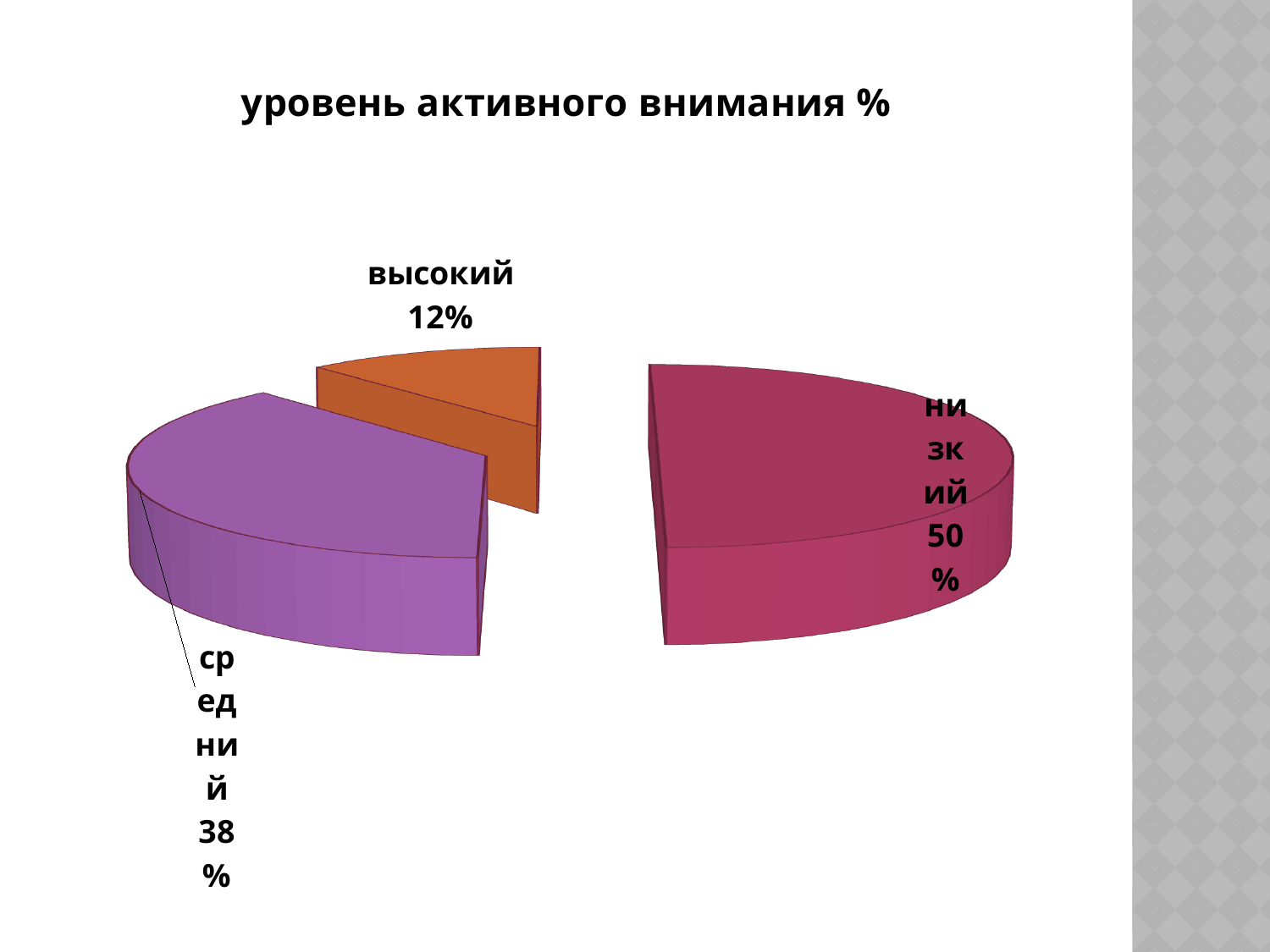
What percentage is shown for the "низкий" slice? 50% Which is larger, the "средний" share or the "высокий" share? средний Which category has the largest share of the pie? низкий How many slices does the pie chart have? 3 What colour is the "высокий" slice? orange Which category has the smallest share of the pie? высокий What is the difference between the "низкий" and "средний" shares? 12% What is the title of the chart? уровень активного внимания % What kind of chart is shown on the slide? pie chart What percentage is shown for the "средний" slice? 38% What percentage is shown for the "высокий" slice? 12% What is the difference between the "средний" and "высокий" shares? 26%